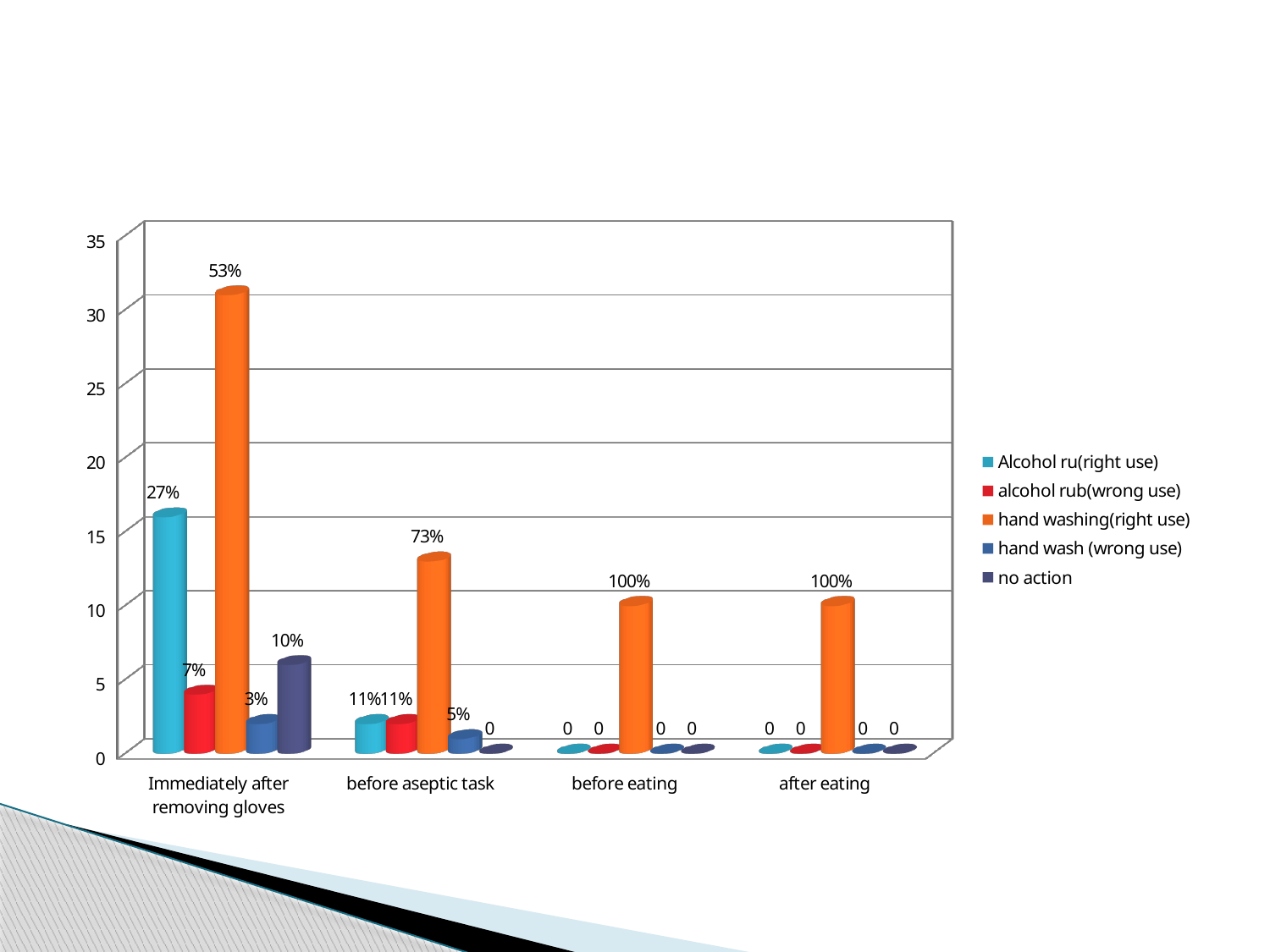
How many series does the legend list? 5 What is the value for hand washing (right use) in the 'before eating' category? 100% Is the hand washing (right use) bar for 'Immediately after removing gloves' greater or less than 30 on the axis? greater What is the value for Alcohol ru(right use) in the 'Immediately after removing gloves' category? 27% In the 'before aseptic task' category, which is larger: hand washing (right use) or hand wash (wrong use)? hand washing (right use) Within the 'Immediately after removing gloves' category, which series has the lowest value? hand wash (wrong use) What is the value for hand washing (right use) in the 'before aseptic task' category? 73% What is the value for no action in the 'Immediately after removing gloves' category? 10% Within the 'Immediately after removing gloves' category, which series has the highest value? hand washing (right use) What is the value for hand washing (right use) in the 'Immediately after removing gloves' category? 53% How many categories are shown on the x axis? 4 What is the difference between the hand washing (right use) value and the Alcohol ru(right use) value in the 'Immediately after removing gloves' category? 26%